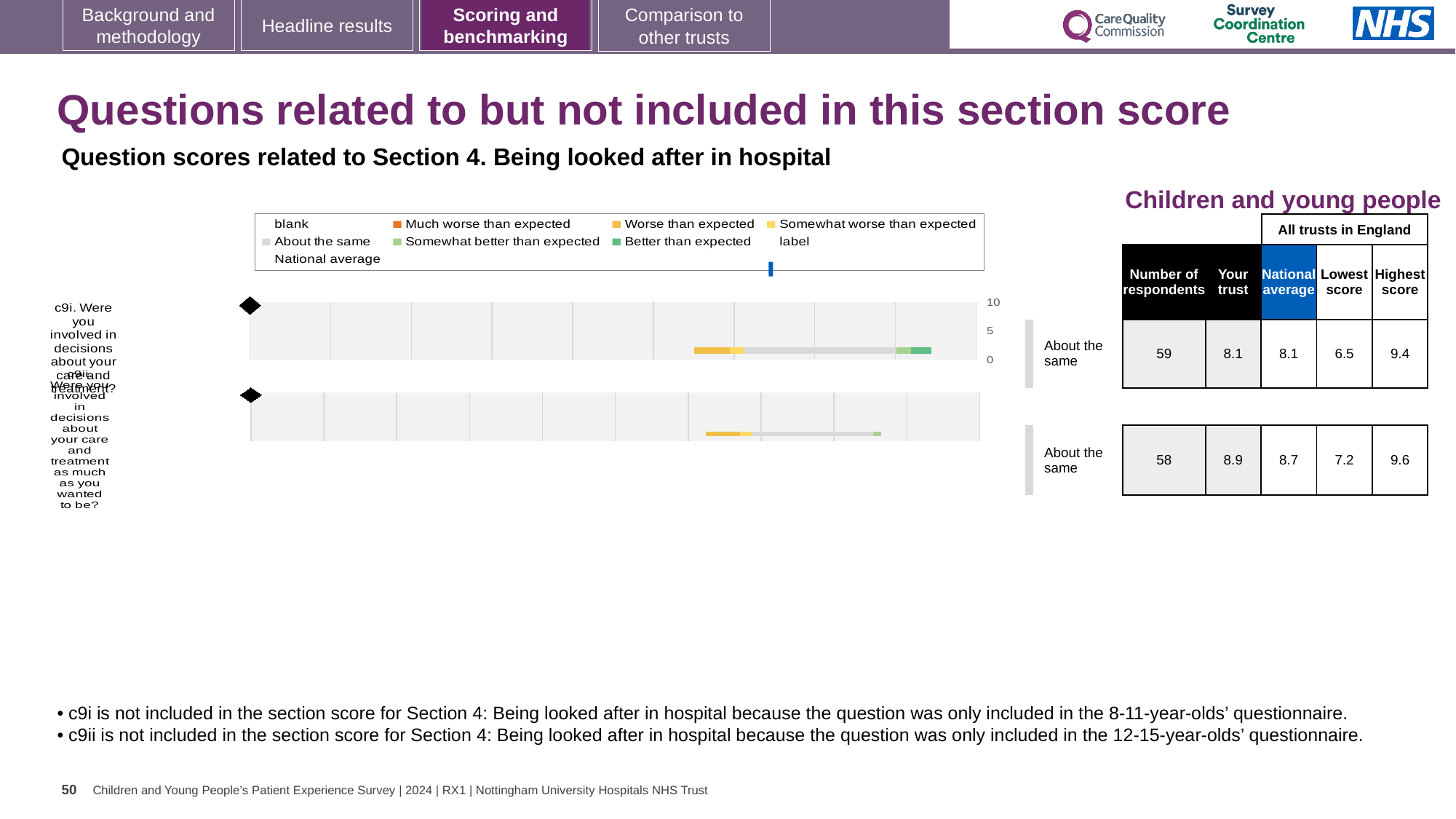
What colour represents 'Better than expected' in the chart legend? green What kind of chart is used to show the question scores for c9i and c9ii? bar chart What is the highest score among all trusts in England for question c9ii? 9.6 How much higher is the 'Your trust' score for c9ii than for c9i? 0.8 How many respondents answered question c9i? 59 How many questions are plotted in the chart area? 2 What is the 'Your trust' score for question c9i? 8.1 What is the lowest score among all trusts in England for question c9i? 6.5 What is the difference between the highest score and the lowest score for question c9i? 2.9 What benchmark category is shown next to the bar for question c9i? About the same For question c9ii, which is larger: the 'Your trust' score or the national average? Your trust What is the national average score for question c9ii? 8.7